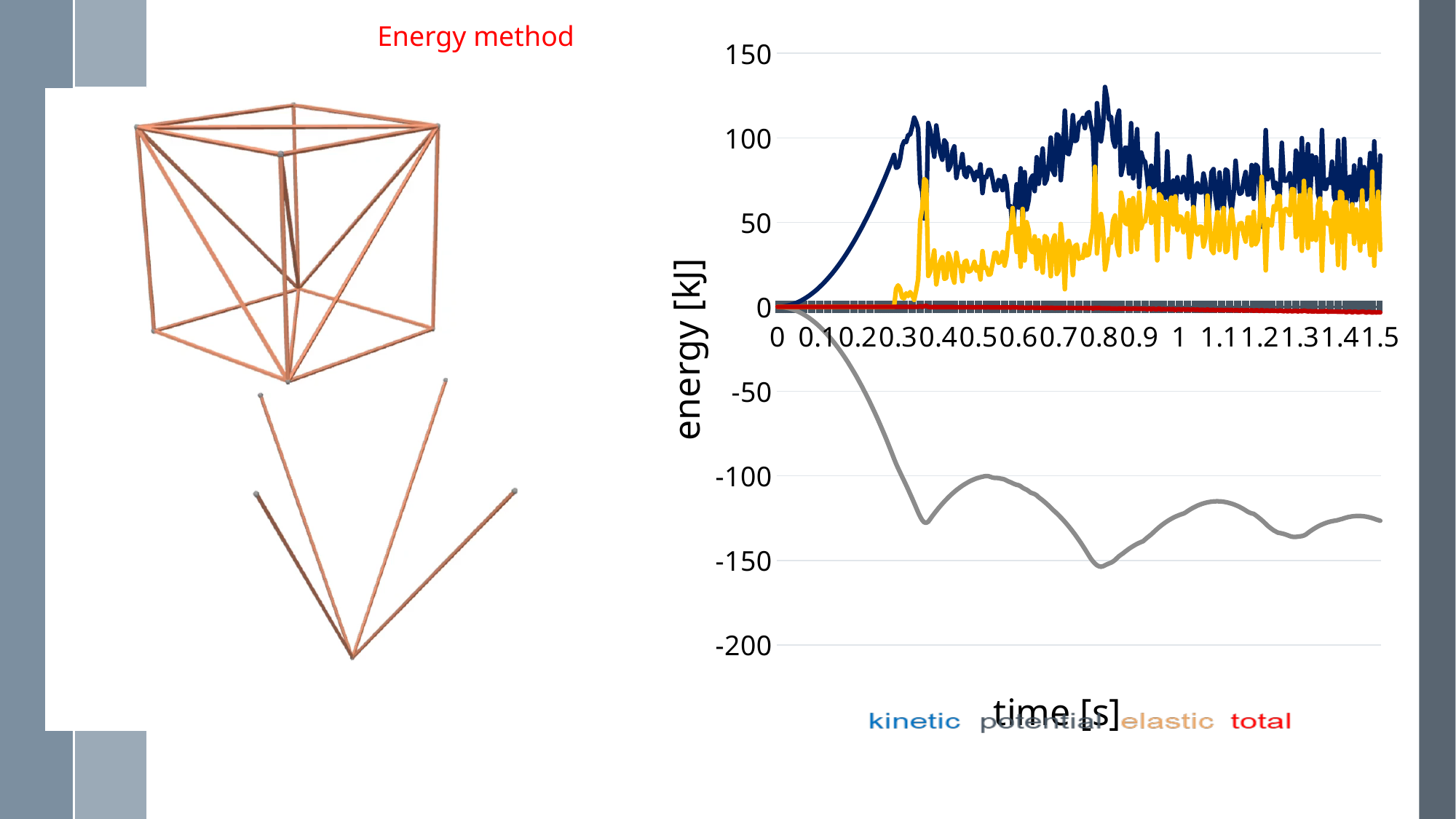
What is the label of the y axis of the chart? energy [kJ] Is the value of the elastic series at 0.5 s greater or less than 50? less At 0.8 s, which series has the larger value, kinetic or elastic? kinetic Is the value of the potential series at 0.8 s greater or less than -100? less Is the value of the potential series at 0.5 s greater or less than -150? greater What kind of chart is shown on the slide? line chart How many series does the chart's legend list? 4 What is the label of the x axis of the chart? time [s] Which series in the chart has the lowest values, staying below zero for most of the time range? potential Which series in the chart reaches the highest values? kinetic Does the potential series overall rise or fall from 0 s to 1.5 s? fall